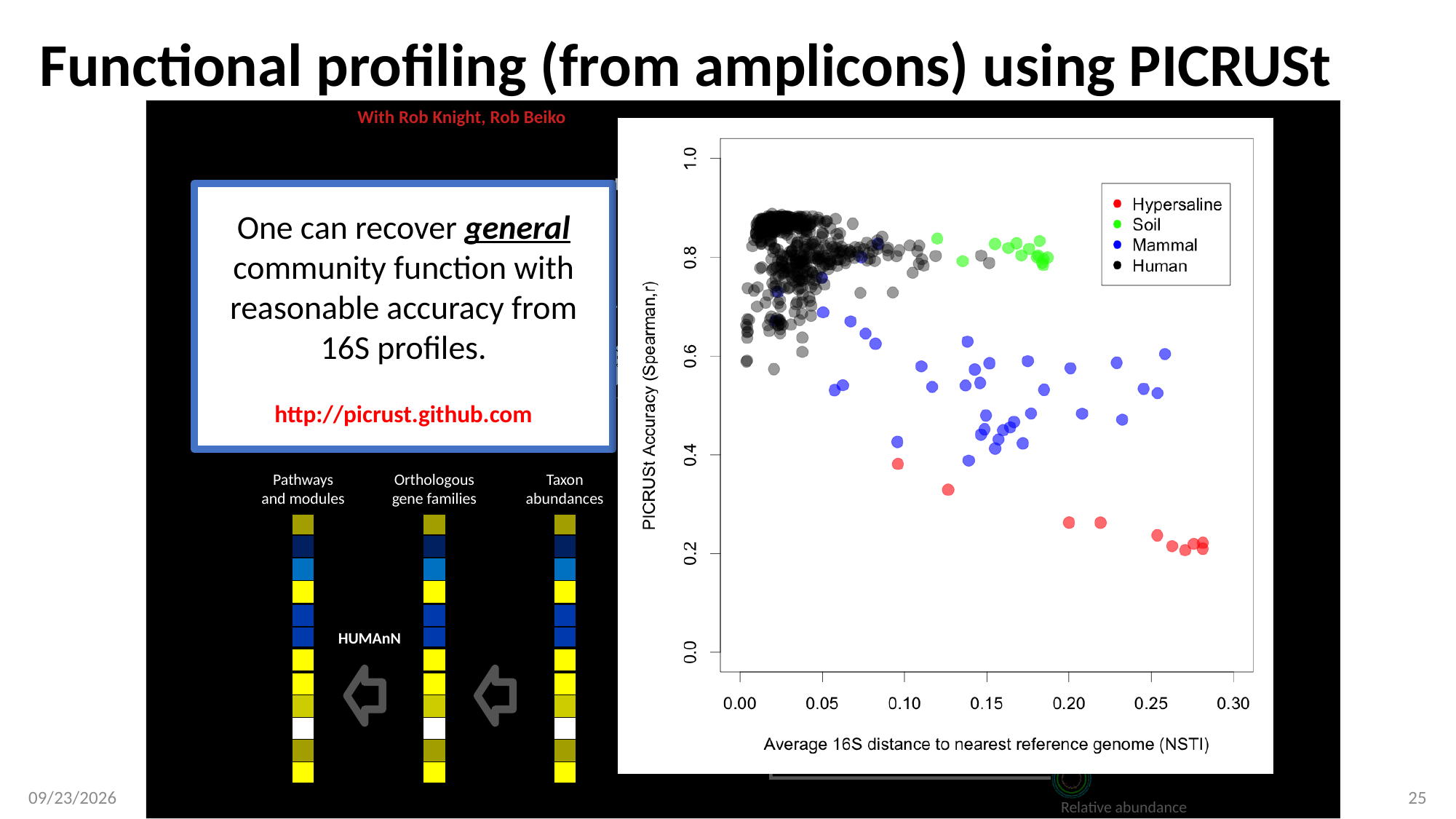
In the scatter plot, which group has the lowest PICRUSt accuracy values? Hypersaline In the scatter plot, are the NSTI values for the Soil samples greater or less than 0.10? greater Which groups are listed in the legend of the scatter plot? Hypersaline, Soil, Mammal, Human In the scatter plot, do the Soil samples or the Hypersaline samples have higher PICRUSt accuracy? Soil In the scatter plot, are the PICRUSt accuracy values for the Soil samples greater or less than 0.6? greater What is the label of the y axis of the scatter plot? PICRUSt Accuracy (Spearman,r) In the scatter plot, does PICRUSt accuracy generally rise or fall as the average 16S distance (NSTI) increases? fall In the scatter plot, which group has the largest NSTI values (furthest right on the x axis)? Hypersaline In the scatter plot, which group has the smallest NSTI values (furthest left on the x axis)? Human What kind of chart is shown on the right side of the slide? scatter plot How many groups does the legend of the scatter plot list? 4